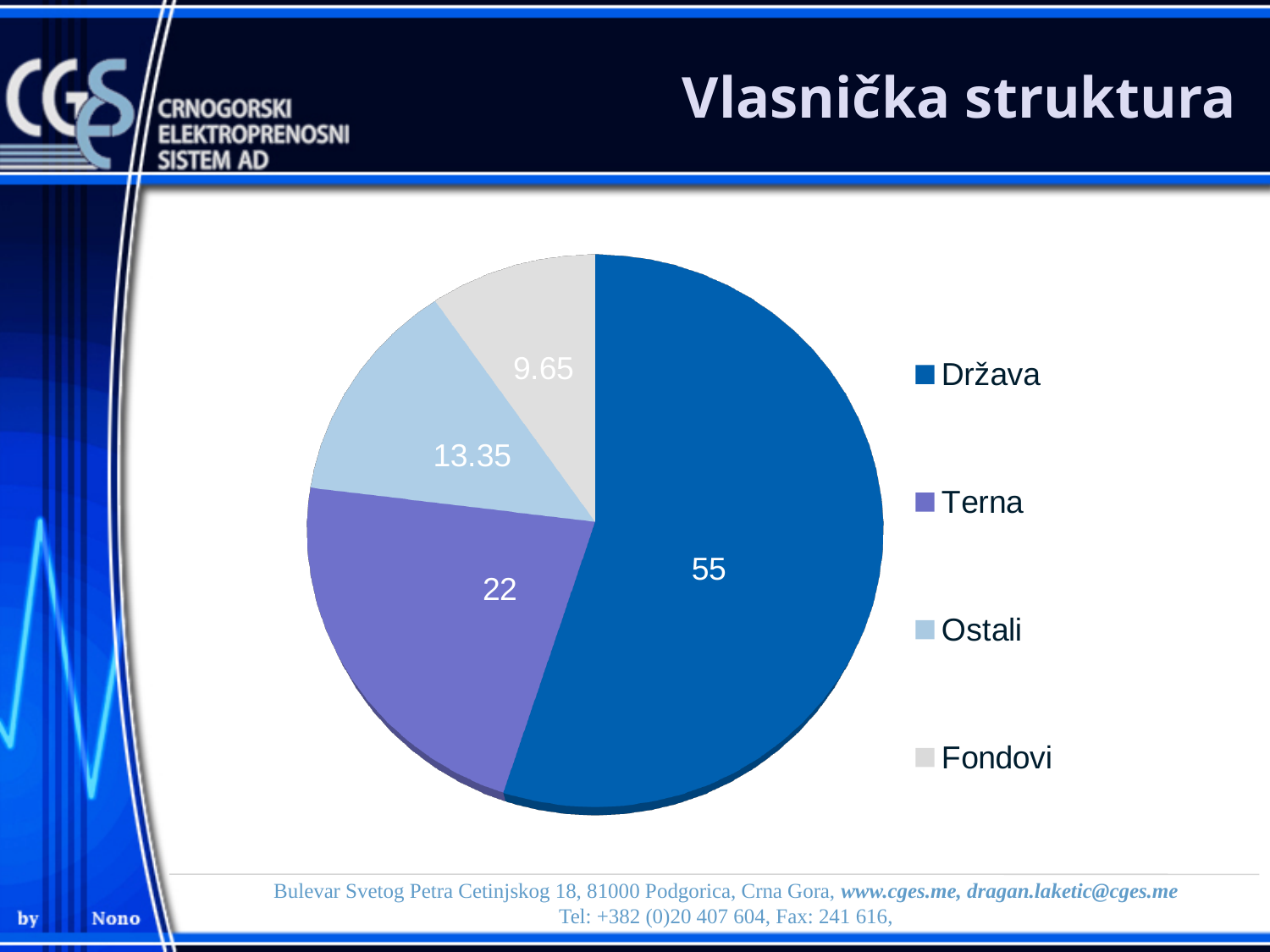
What is the value for Terna? 22 What is the value for Fondovi? 9.65 What is the difference between the values for Država and Terna? 33 Which category has the smallest slice of the pie? Fondovi What is the value for Ostali? 13.35 What kind of chart is shown on the slide? Pie chart What is the value for Država? 55 Which category has the largest slice of the pie? Država What is the difference between the values for Ostali and Fondovi? 3.7 How many slices does the pie chart have? 4 Which is larger, the value for Terna or the value for Ostali? Terna What is the title of the slide containing the chart? Vlasnička struktura